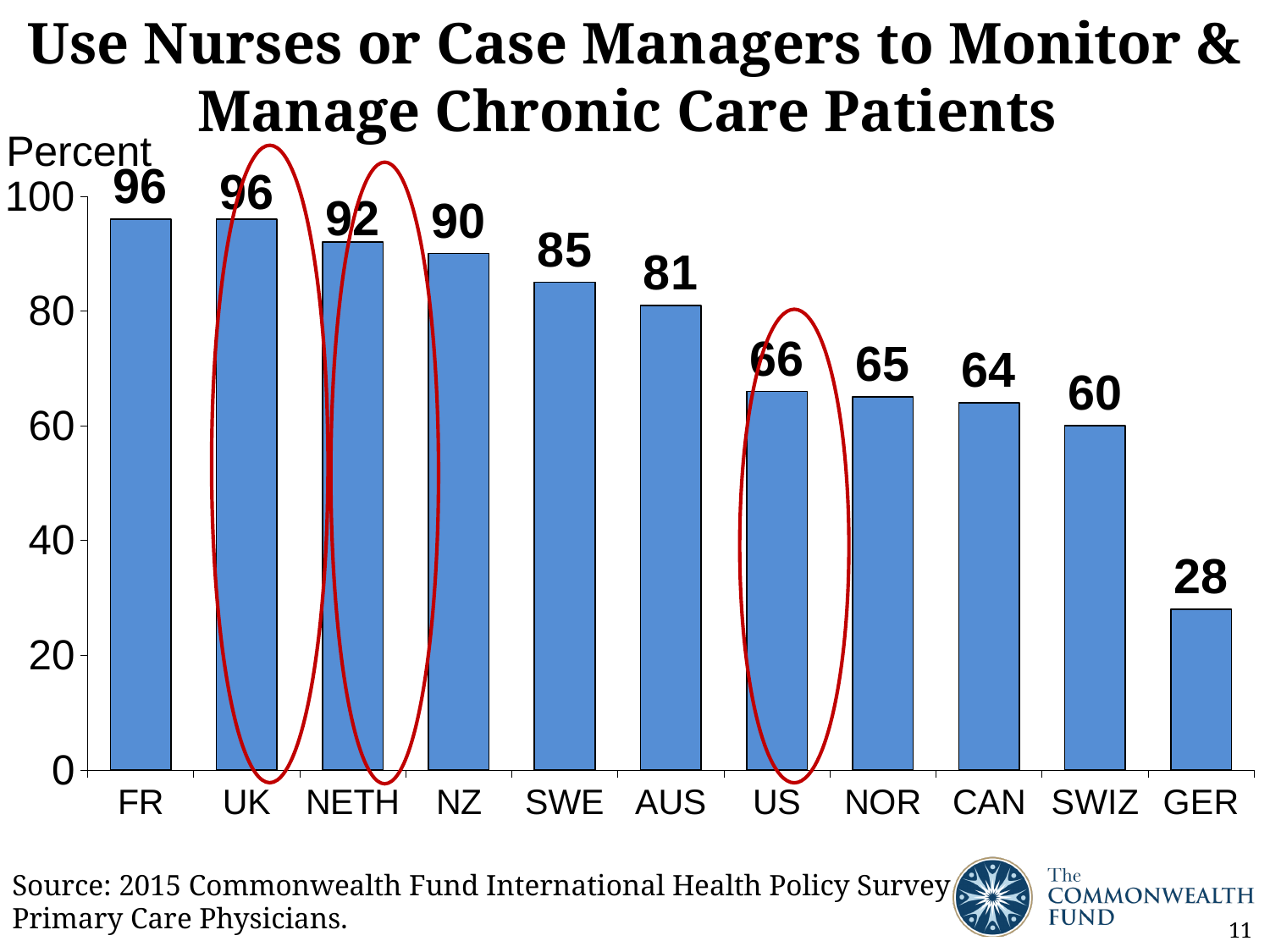
What is the difference between the values for NZ and US? 24 What kind of chart is shown on the slide? bar chart What is the value for GER? 28 What is the value for NETH? 92 How many countries are shown on the chart? 11 Which country has the lowest value? GER Which is larger, the value for SWE or the value for NOR? SWE What is the value for the US? 66 What is the difference between the values for FR and GER? 68 Is the value for SWIZ greater or less than 80? less Do the values rise or fall from left to right across the chart? fall What is the label on the vertical axis? Percent